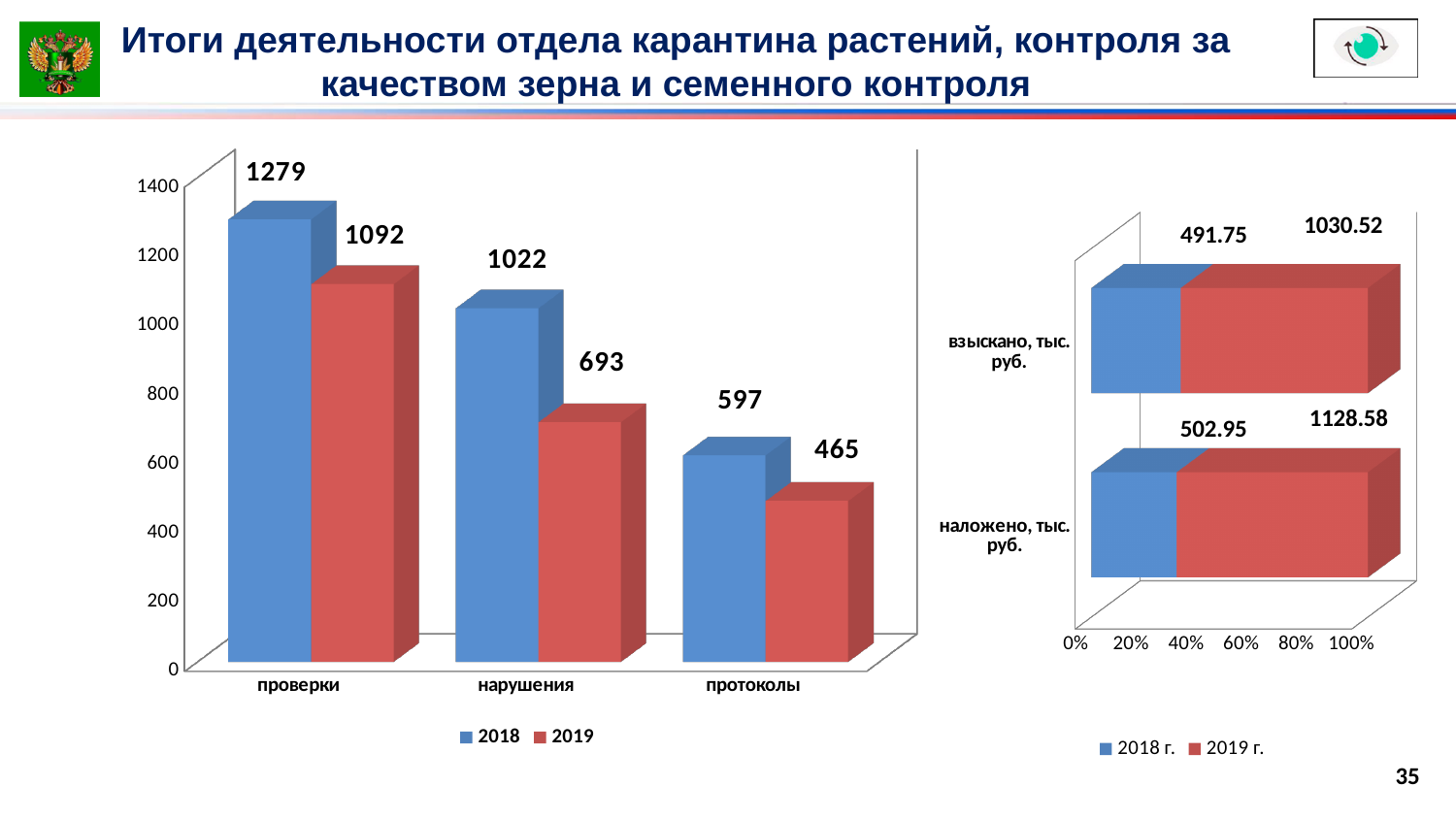
In the right chart, what is the 2019 г. value for взыскано, тыс. руб.? 1030.52 What kind of chart is the left chart? bar chart In the left chart, what is the difference between the 2018 and 2019 values for проверки? 187 In the left chart, how many categories are shown on the x axis? 3 In the left chart, what is the value for проверки in 2018? 1279 How many series does the legend of the right chart list? 2 In the right chart, what is the 2018 г. value for наложено, тыс. руб.? 502.95 In the left chart, which category has the lowest value for 2018? протоколы In the left chart, which is larger: the 2019 value for нарушения or the 2018 value for протоколы? 2019 value for нарушения In the left chart, what is the value for нарушения in 2019? 693 In the left chart, do the 2018 values rise or fall from проверки to протоколы? fall In the left chart, what is the value for протоколы in 2019? 465